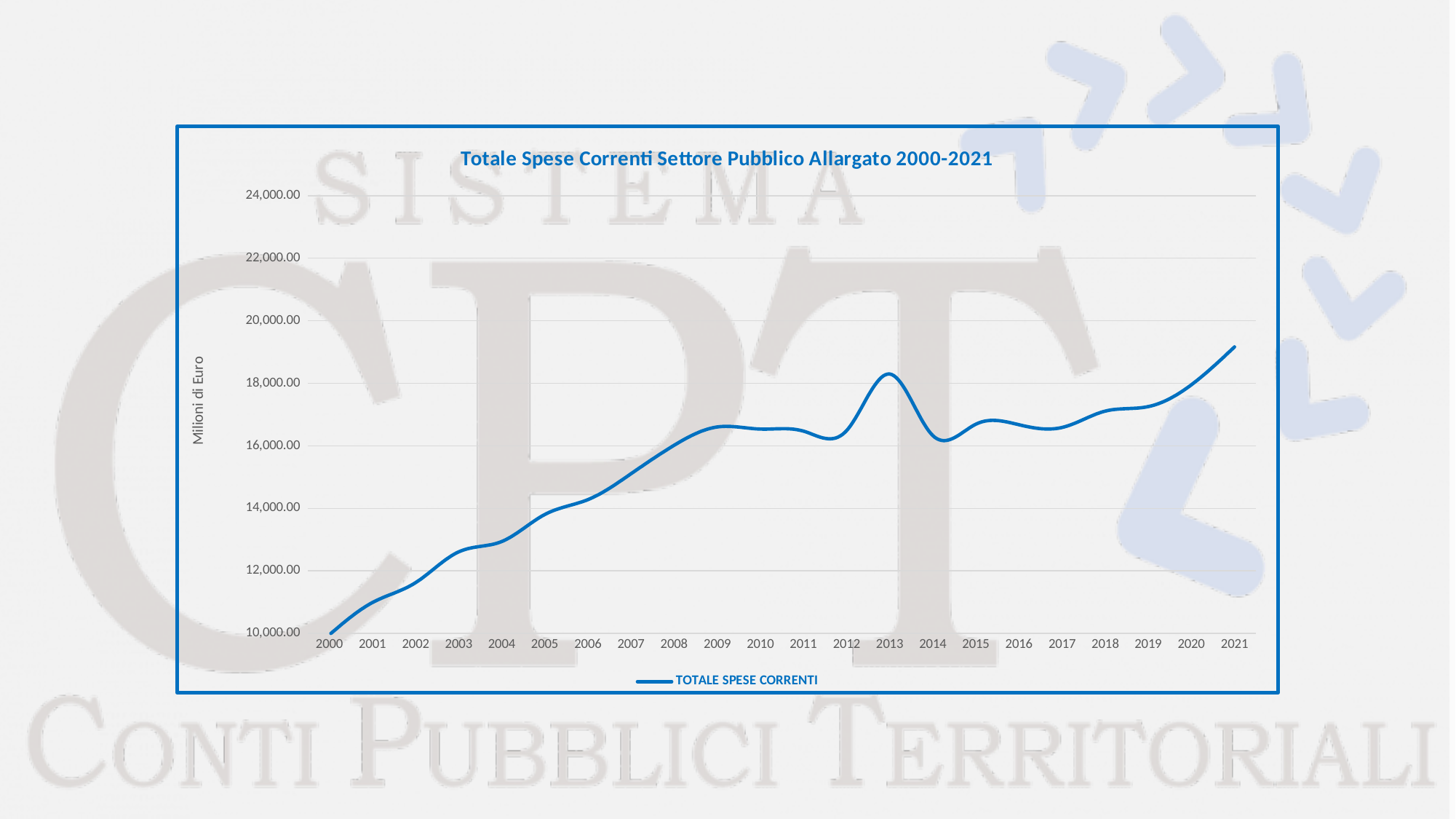
How many years are plotted along the x axis? 22 Which year has the highest value for TOTALE SPESE CORRENTI? 2021 Which year has the lowest value for TOTALE SPESE CORRENTI? 2000 Is the value for 2021 greater or less than 20,000.00? less How many series does the legend list? 1 What is the title of the chart? Totale Spese Correnti Settore Pubblico Allargato 2000-2021 Is the value for 2013 greater or less than 18,000.00? greater Which year has the larger value, 2013 or 2014? 2013 Does the value generally rise or fall from 2000 to 2021? rise What kind of chart is shown on the slide? line chart Is the value for 2005 greater or less than 14,000.00? less